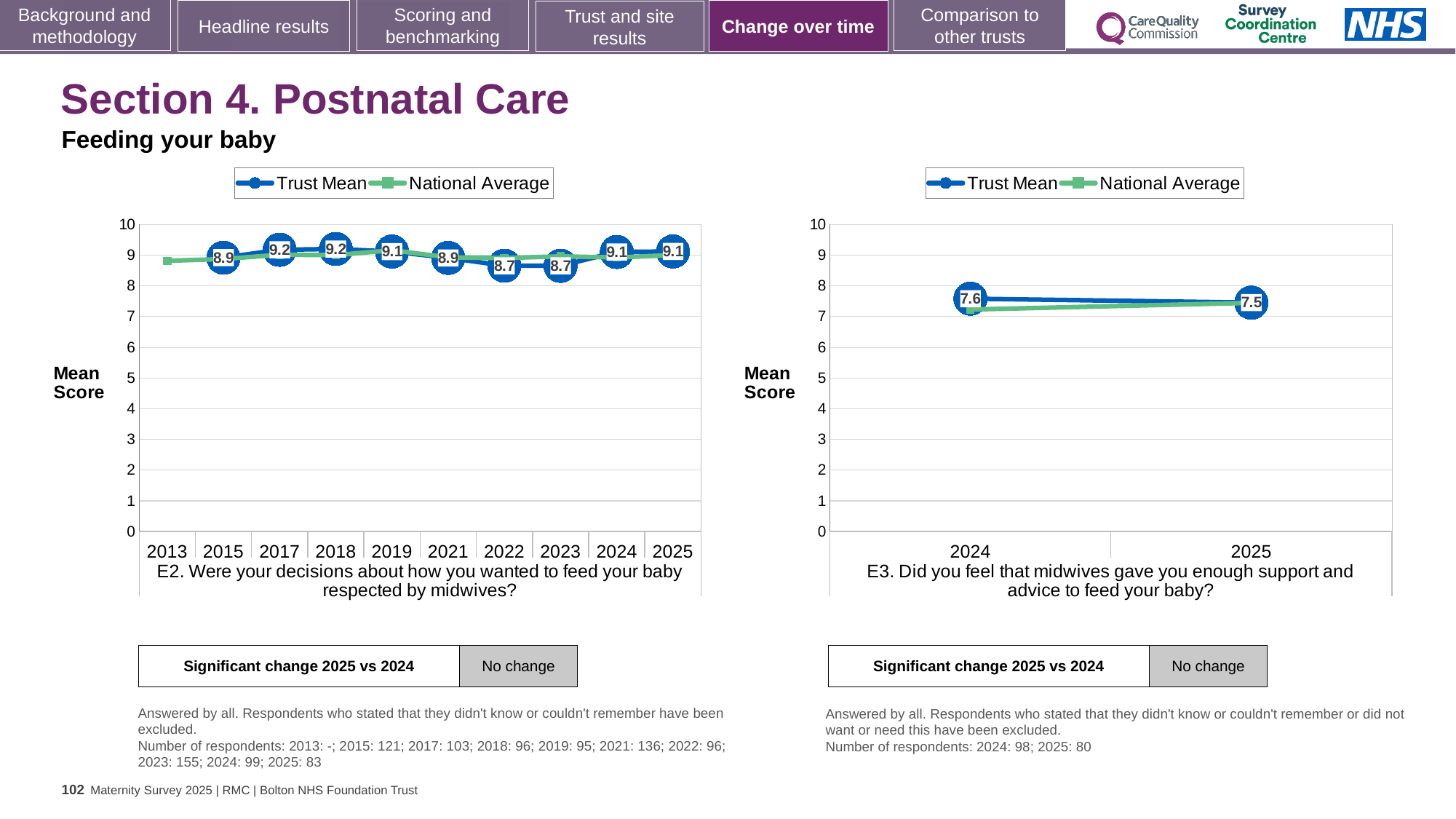
In the right chart (E3), what is the difference between the Trust Mean for 2024 and 2025? 0.1 How many years are shown on the x axis of the left chart (E2)? 10 In the right chart (E3), is the National Average for 2024 greater or less than 8? less In the right chart (E3), does the Trust Mean rise or fall from 2024 to 2025? Fall How many series does the legend of the right chart (E3) list? 2 In the left chart (E2), what is the difference between the Trust Mean for 2018 and the Trust Mean for 2022? 0.5 In the right chart (E3), what is the Trust Mean for 2024? 7.6 In the left chart (E2), which is larger: the Trust Mean for 2017 or the Trust Mean for 2023? 2017 In the left chart (E2), what is the Trust Mean for 2018? 9.2 In the right chart (E3), what is the Trust Mean for 2025? 7.5 In the left chart (E2), what is the Trust Mean for 2022? 8.7 What kind of chart is the left chart (E2)? Line chart